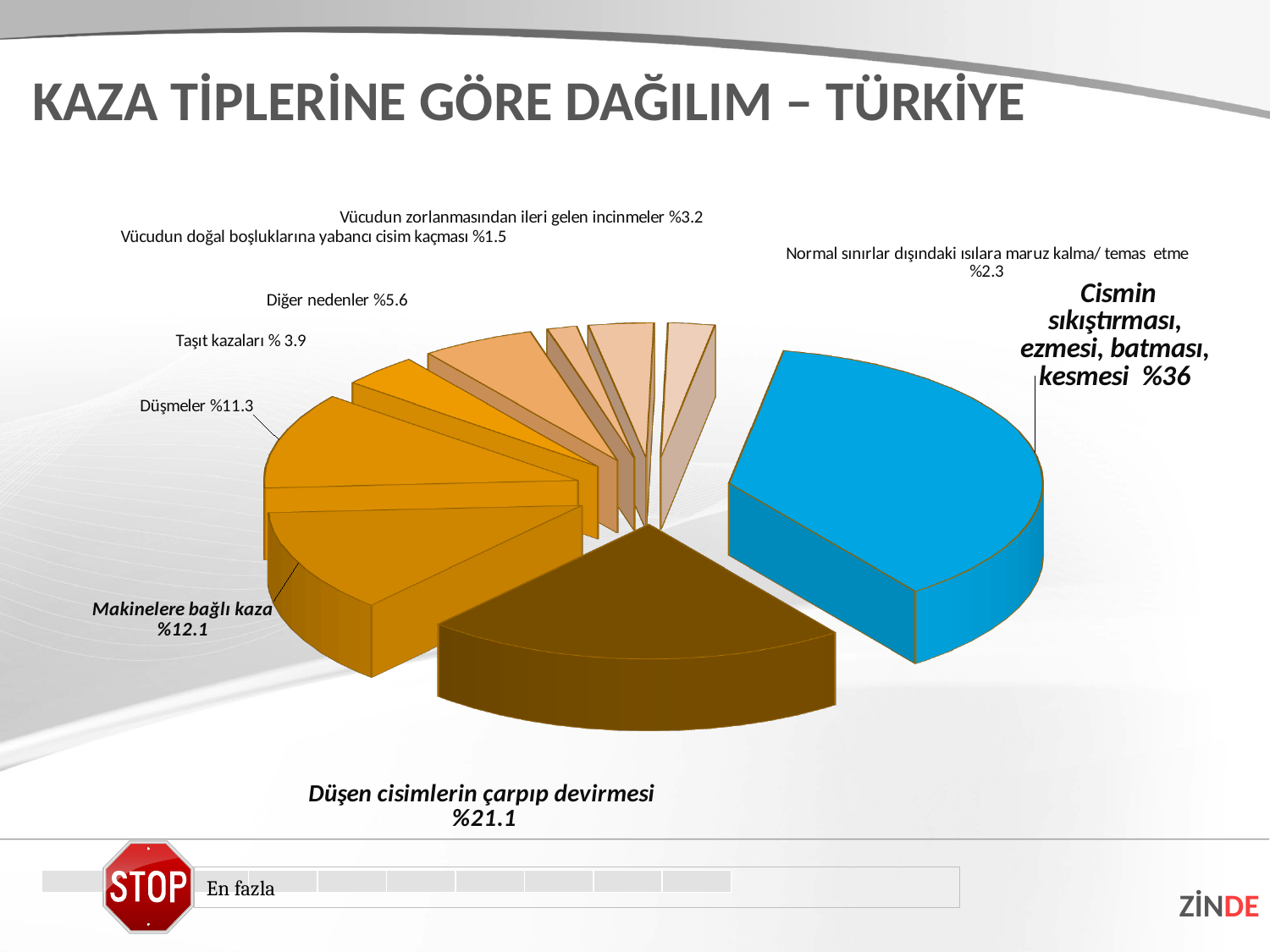
What is the share for "Diğer nedenler"? %5.6 What is the title of the slide containing the pie chart? KAZA TİPLERİNE GÖRE DAĞILIM – TÜRKİYE What type of chart is shown on the slide? pie chart Which accident type has the largest share in the pie chart? Cismin sıkıştırması, ezmesi, batması, kesmesi Which accident type has the smallest share in the pie chart? Vücudun doğal boşluklarına yabancı cisim kaçması What is the share for "Cismin sıkıştırması, ezmesi, batması, kesmesi"? %36 What is the difference between the shares of "Cismin sıkıştırması, ezmesi, batması, kesmesi" and "Düşen cisimlerin çarpıp devirmesi"? 14.9 percentage points What is the share for "Düşmeler"? %11.3 Which has a larger share: "Makinelere bağlı kaza" or "Düşmeler"? Makinelere bağlı kaza What is the share for "Makinelere bağlı kaza"? %12.1 What is the share for "Düşen cisimlerin çarpıp devirmesi"? %21.1 What is the share for "Vücudun doğal boşluklarına yabancı cisim kaçması"? %1.5